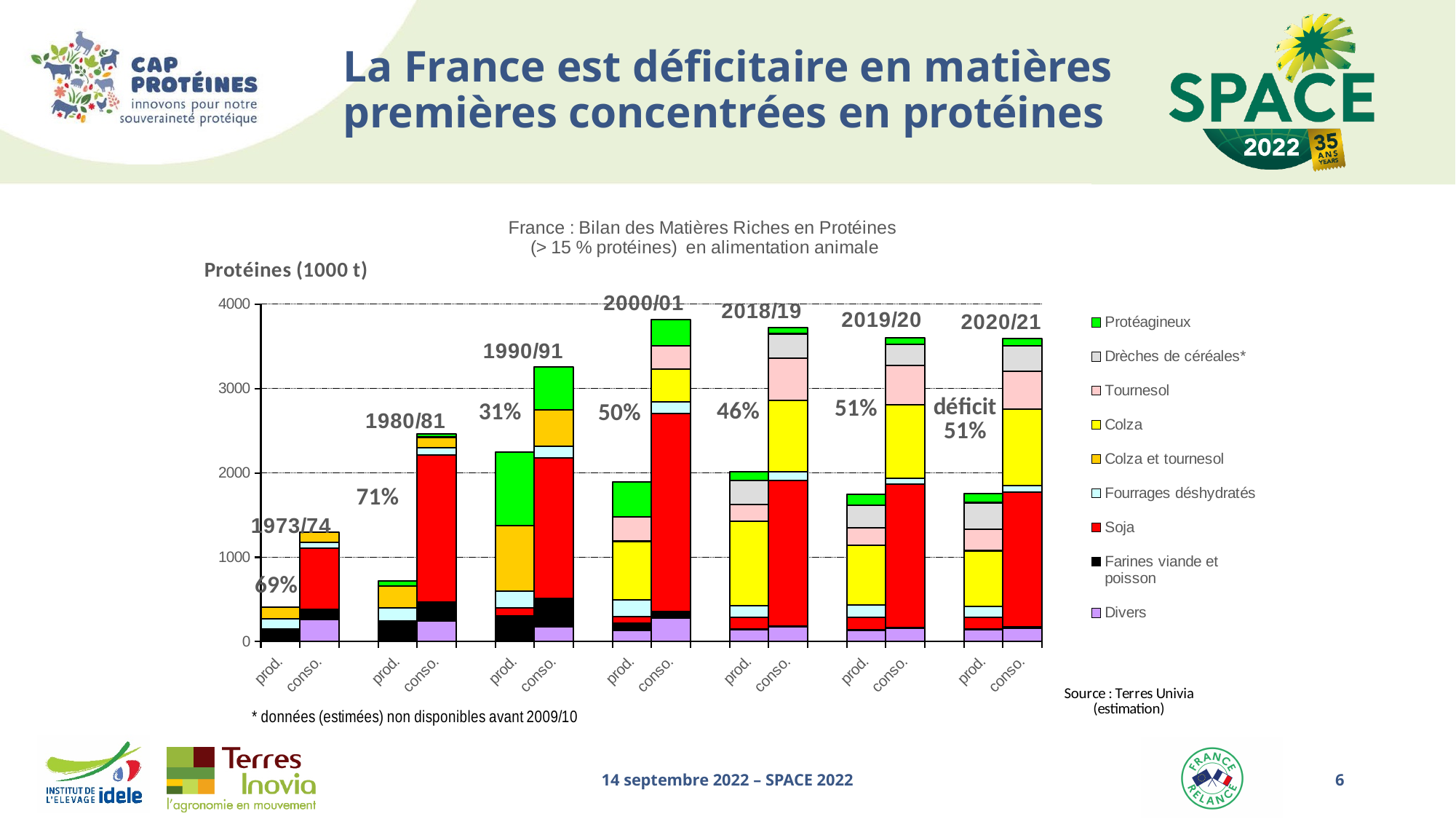
What deficit percentage is shown for 2020/21? 51% What kind of chart is shown on the slide? Stacked bar chart What is the difference between the deficit percentages for 2019/20 and 2018/19? 5 percentage points What deficit percentage is shown for 1980/81? 71% Which period shows the lowest deficit percentage? 1990/91 In 2000/01, which bar is taller, prod. or conso.? conso. Which period shows the highest deficit percentage? 1980/81 How many campaign periods (years) are shown on the chart? 7 How many series does the chart legend list? 9 What is the unit label shown on the y axis of the chart? Protéines (1000 t) Is the total of the conso. bar for 2000/01 greater or less than 3000? greater Is the total of the prod. bar for 1973/74 greater or less than 1000? less